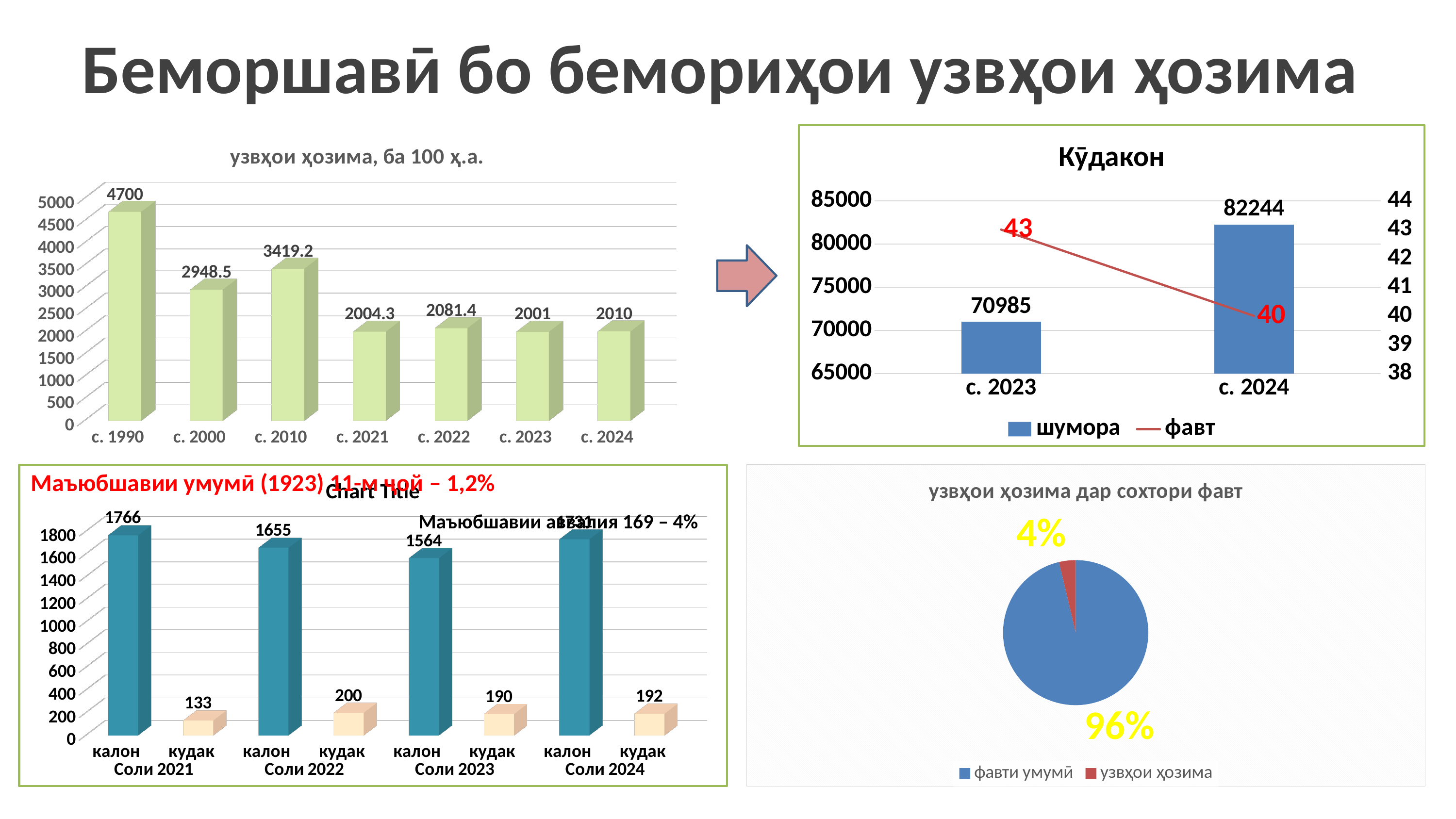
In the chart titled "узвҳои ҳозима, ба 100 ҳ.а.", which year has the lowest value? с. 2023 What kind of chart is the chart titled "узвҳои ҳозима дар сохтори фавт"? pie chart In the pie chart titled "узвҳои ҳозима дар сохтори фавт", what share does узвҳои ҳозима have? 4% In the chart titled "Кӯдакон", what is the шумора value for с. 2024? 82244 In the chart titled "узвҳои ҳозима, ба 100 ҳ.а.", what is the difference between the values for с. 2000 and с. 2010? 470.7 How many series does the legend of the chart titled "Кӯдакон" list? 2 In the bottom-left bar chart, what is the value for кудак in Соли 2022? 200 In the chart titled "Кӯдакон", what is the difference in шумора between с. 2024 and с. 2023? 11259 In the chart titled "узвҳои ҳозима, ба 100 ҳ.а.", what is the value for с. 1990? 4700 In the chart titled "Кӯдакон", what is the фавт value for с. 2023? 43 How many years are shown in the chart titled "узвҳои ҳозима, ба 100 ҳ.а."? 7 In the bottom-left bar chart, which is larger: калон in Соли 2021 or калон in Соли 2023? калон in Соли 2021